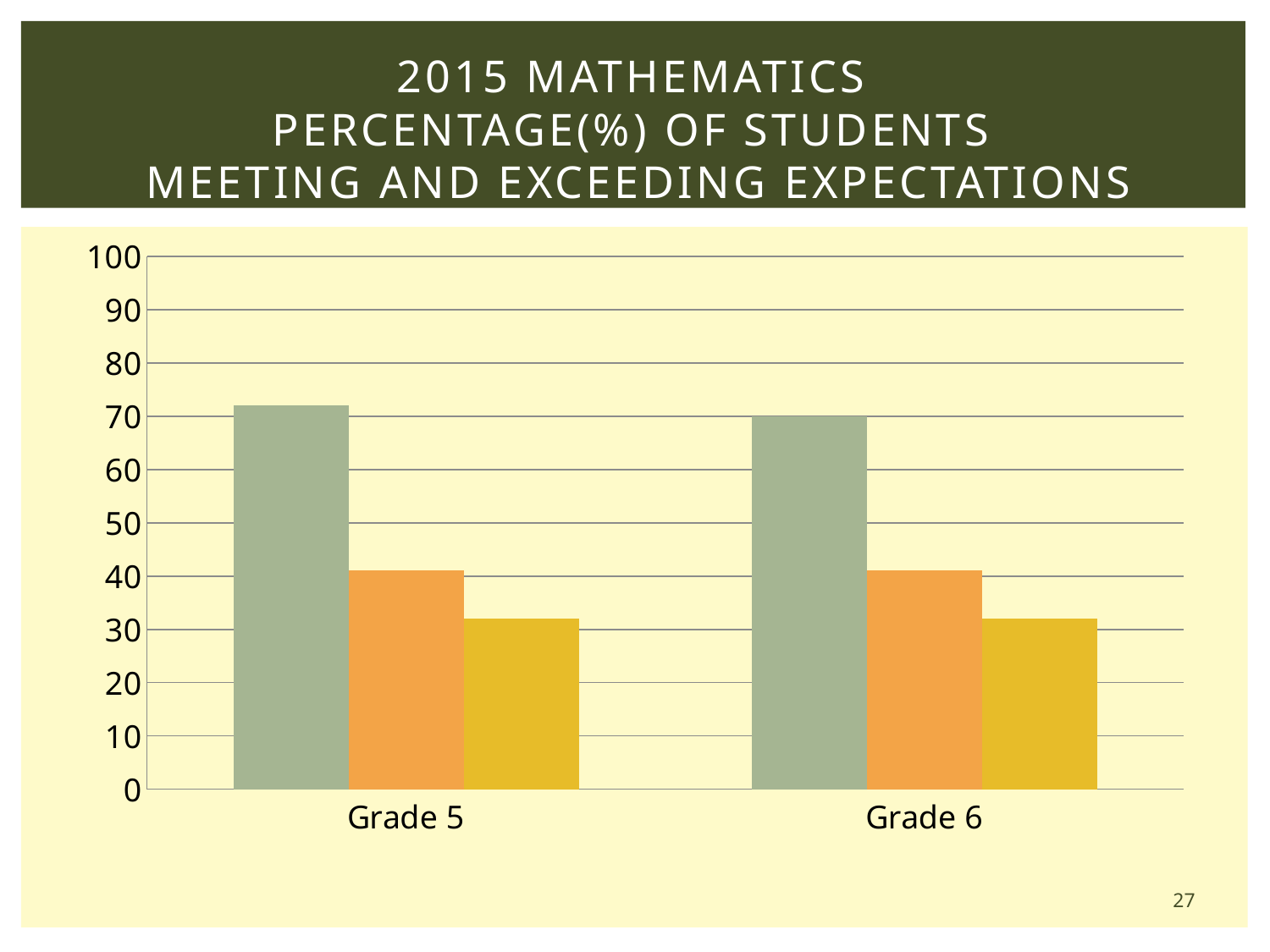
For Grade 5, which is larger: the green bar or the orange bar? the green bar What kind of chart is shown on the slide? bar chart What is the highest value shown on the vertical axis? 100 Is the value of the yellow bar for Grade 6 greater or less than 20? greater For Grade 6, which is larger: the orange bar or the yellow bar? the orange bar How many grade categories are shown on the x axis? 2 How many bars are plotted for each grade? 3 Is the value of the orange bar for Grade 5 greater or less than 50? less Is the value of the green bar for Grade 5 greater or less than 60? greater